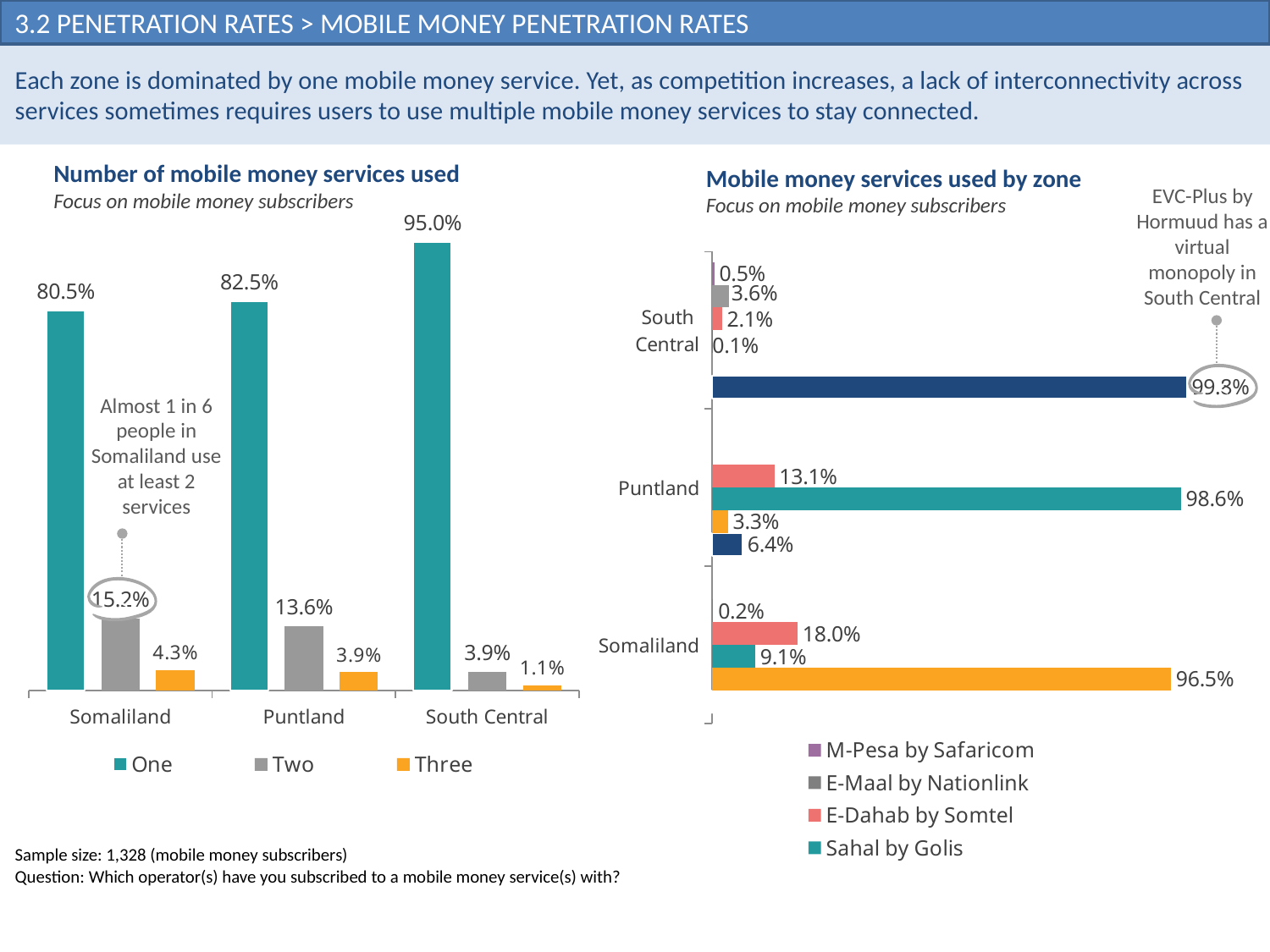
How many series does the legend of the 'Number of mobile money services used' chart list? 3 In the 'Number of mobile money services used' chart, does the 'One' value rise or fall from Somaliland to South Central? Rise In the 'Mobile money services used by zone' chart, what is the value for Sahal by Golis in Puntland? 98.6% In the 'Mobile money services used by zone' chart, what is the value for E-Dahab by Somtel in Somaliland? 18.0% How many zones are shown on the x axis of the 'Number of mobile money services used' chart? 3 In the 'Mobile money services used by zone' chart, what is the value for E-Maal by Nationlink in South Central? 3.6% In the 'Number of mobile money services used' chart, what percentage of Somaliland subscribers use one service? 80.5% In the 'Number of mobile money services used' chart, what is the value for 'Two' services in Puntland? 13.6% What type of chart is 'Number of mobile money services used'? Bar chart In the 'Number of mobile money services used' chart, which zone has the highest share of subscribers using one service? South Central In the 'Mobile money services used by zone' chart, is the E-Dahab by Somtel value larger in Puntland or in Somaliland? Somaliland In the 'Number of mobile money services used' chart, what is the difference between the 'One' values for Puntland and Somaliland? 2.0 percentage points